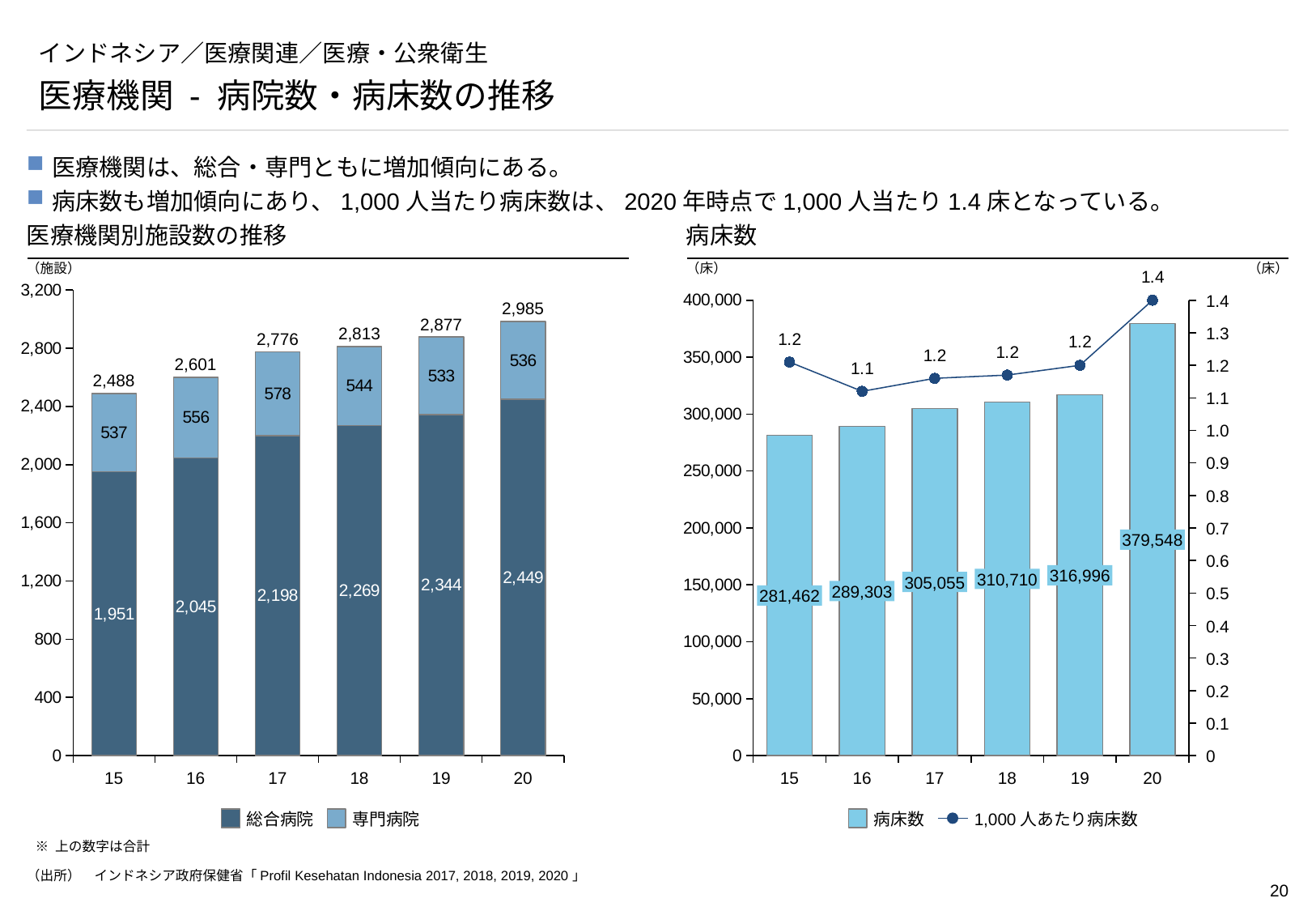
In the 病床数 chart, which year has the lowest 病床数? 15 In the 医療機関別施設数の推移 chart, what is the difference between the 総合病院 values for 19 and 18? 75 What kind of chart is the 病床数 chart? Bar chart with a line In the 医療機関別施設数の推移 chart, do the 総合病院 values rise or fall from 15 to 20? rise In the 病床数 chart, what is the difference in 病床数 between 20 and 19? 62,552 In the 医療機関別施設数の推移 chart, what is the value for 総合病院 in 20? 2,449 In the 病床数 chart, what is the 病床数 value for 18? 310,710 In the 医療機関別施設数の推移 chart, how many series does the legend list? 2 In the 医療機関別施設数の推移 chart, which year has the highest total? 20 In the 医療機関別施設数の推移 chart, what is the total of the stacked bar for 15? 2,488 In the 医療機関別施設数の推移 chart, what is the value for 専門病院 in 17? 578 In the 病床数 chart, what is the 1,000人あたり病床数 value for 20? 1.4